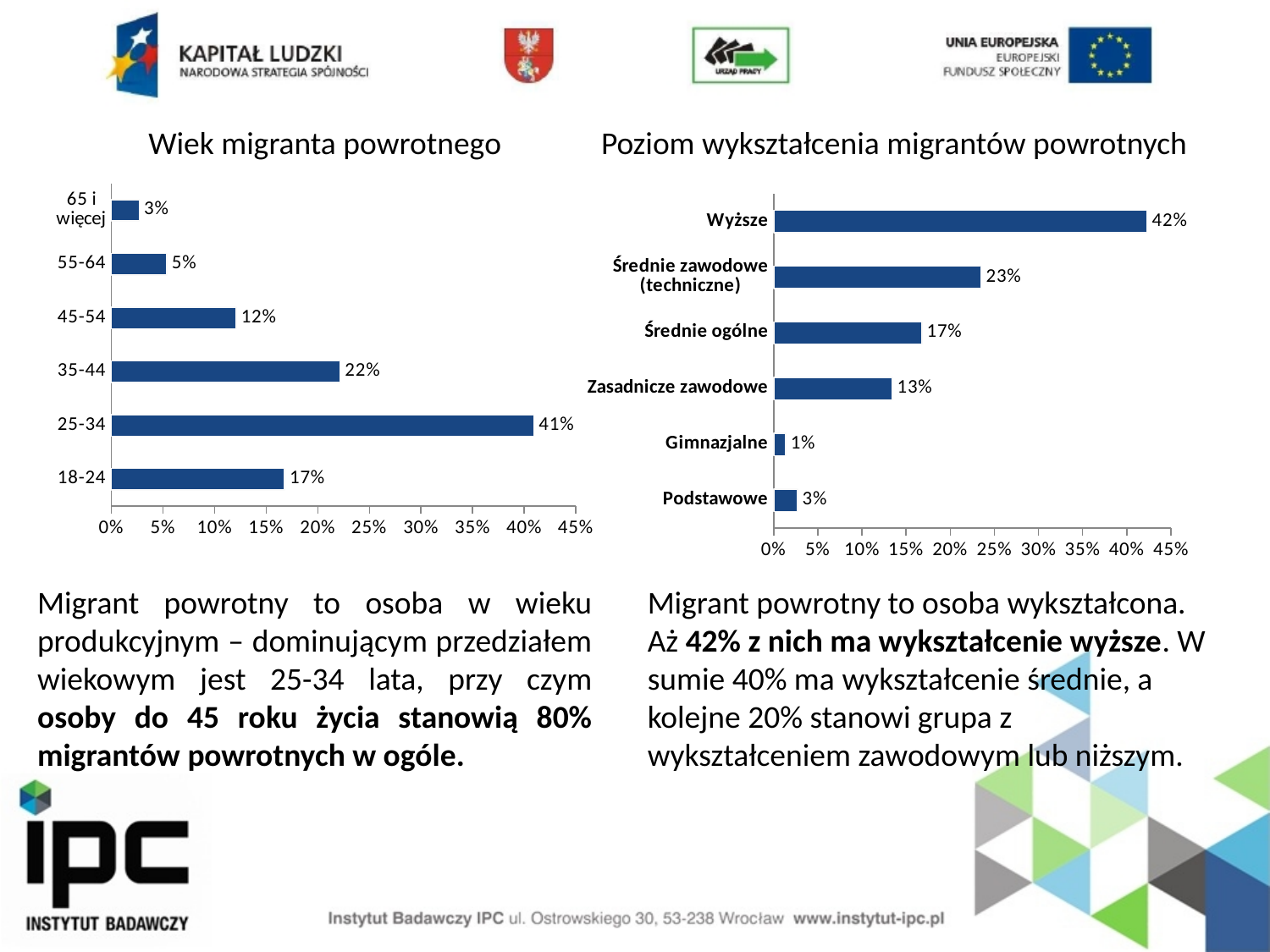
What type of chart is the 'Wiek migranta powrotnego' chart? Bar chart In the 'Poziom wykształcenia migrantów powrotnych' chart, how many education categories are shown? 6 In the 'Poziom wykształcenia migrantów powrotnych' chart, which category has the lowest value? Gimnazjalne In the 'Wiek migranta powrotnego' chart, how many age categories are shown? 6 In the 'Wiek migranta powrotnego' chart, which is larger, the value for 18-24 or the value for 55-64? 18-24 In the 'Wiek migranta powrotnego' chart, what is the difference between the values for 35-44 and 45-54? 10% In the 'Poziom wykształcenia migrantów powrotnych' chart, which category has the highest value? Wyższe In the 'Wiek migranta powrotnego' chart, which age group has the lowest value? 65 i więcej In the 'Poziom wykształcenia migrantów powrotnych' chart, what is the difference between the values for Wyższe and Średnie ogólne? 25% In the 'Poziom wykształcenia migrantów powrotnych' chart, what is the value for Średnie zawodowe (techniczne)? 23% In the 'Wiek migranta powrotnego' chart, what is the value for the 25-34 age group? 41% In the 'Poziom wykształcenia migrantów powrotnych' chart, is the value for Zasadnicze zawodowe greater or less than 15%? less